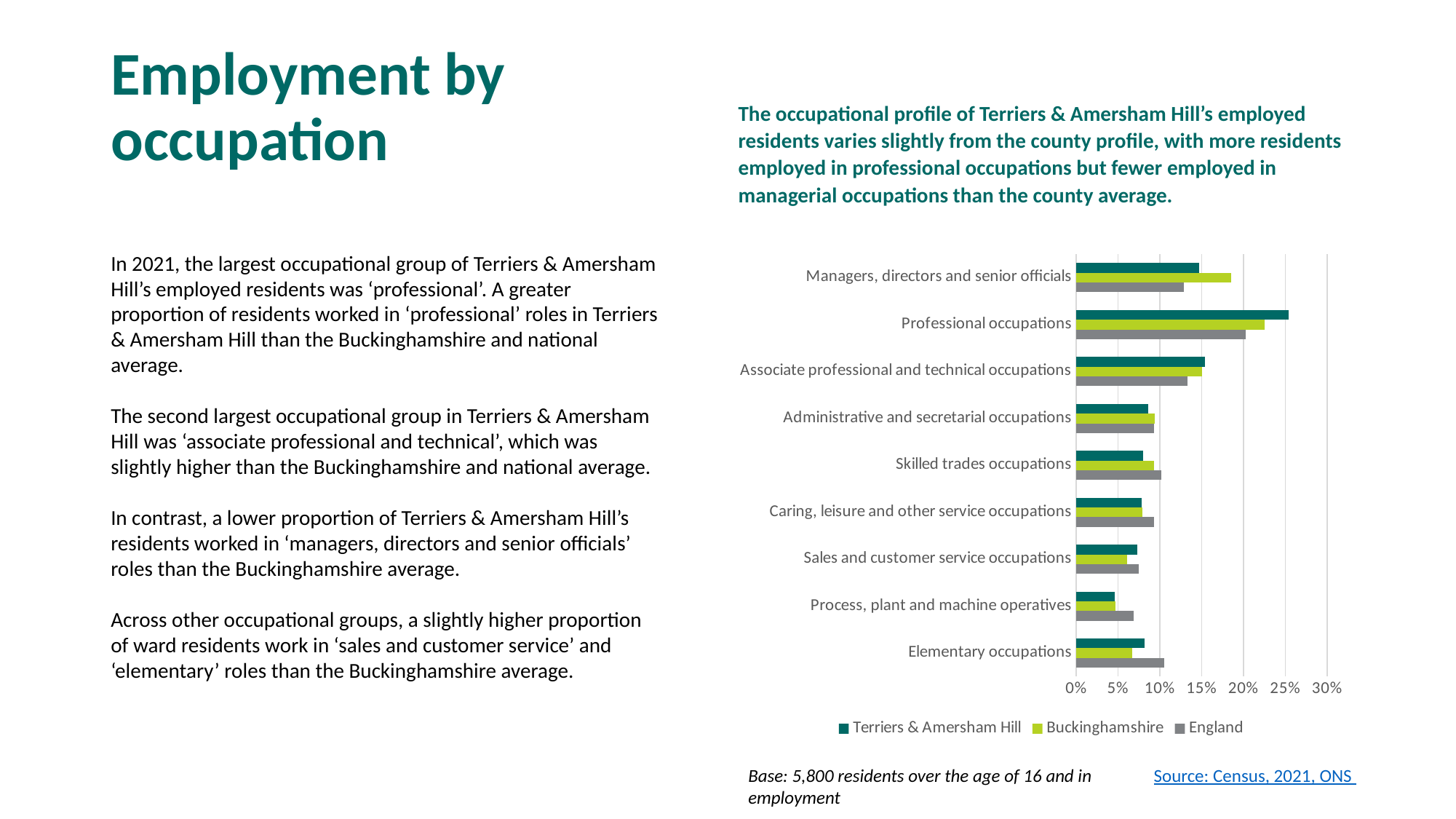
Is the England value for Process, plant and machine operatives greater or less than 10%? less Is the Buckinghamshire value for Managers, directors and senior officials greater or less than 15%? greater How many occupational categories are plotted on the chart? 9 Which occupational category has the highest value for Terriers & Amersham Hill? Professional occupations Is the Terriers & Amersham Hill value for Professional occupations greater or less than 20%? greater For Managers, directors and senior officials, which is larger: the Terriers & Amersham Hill value or the Buckinghamshire value? Buckinghamshire What is the source cited for the chart data? Census, 2021, ONS Which occupational category has the lowest value for Terriers & Amersham Hill? Process, plant and machine operatives For Professional occupations, which is larger: the Terriers & Amersham Hill value or the England value? Terriers & Amersham Hill What kind of chart is shown on the slide? Bar chart Which occupational category has the highest value for England? Professional occupations How many series does the chart legend list? 3